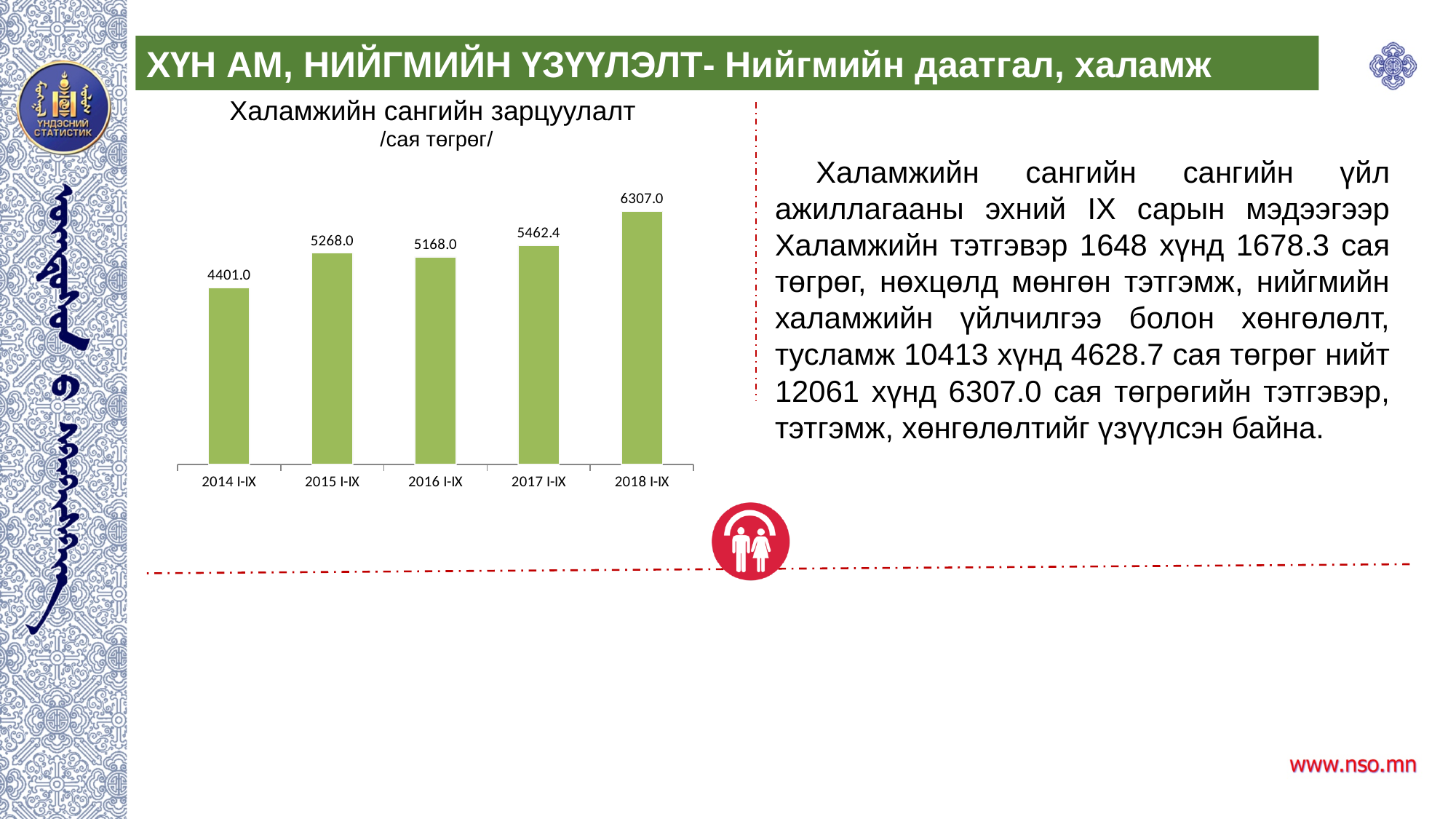
Does the value rise or fall from 2017 I-IX to 2018 I-IX? Rise What is the difference between the values for 2018 I-IX and 2014 I-IX? 1906.0 How many periods are shown on the x axis? 5 Which is larger, the value for 2015 I-IX or 2016 I-IX? 2015 I-IX What is the title of the chart? Халамжийн сангийн зарцуулалт Which period has the highest value? 2018 I-IX What is the difference between the values for 2015 I-IX and 2016 I-IX? 100.0 What kind of chart is shown? Bar chart What is the value for 2017 I-IX? 5462.4 Which period has the lowest value? 2014 I-IX What is the value for 2018 I-IX? 6307.0 What is the value for 2014 I-IX? 4401.0